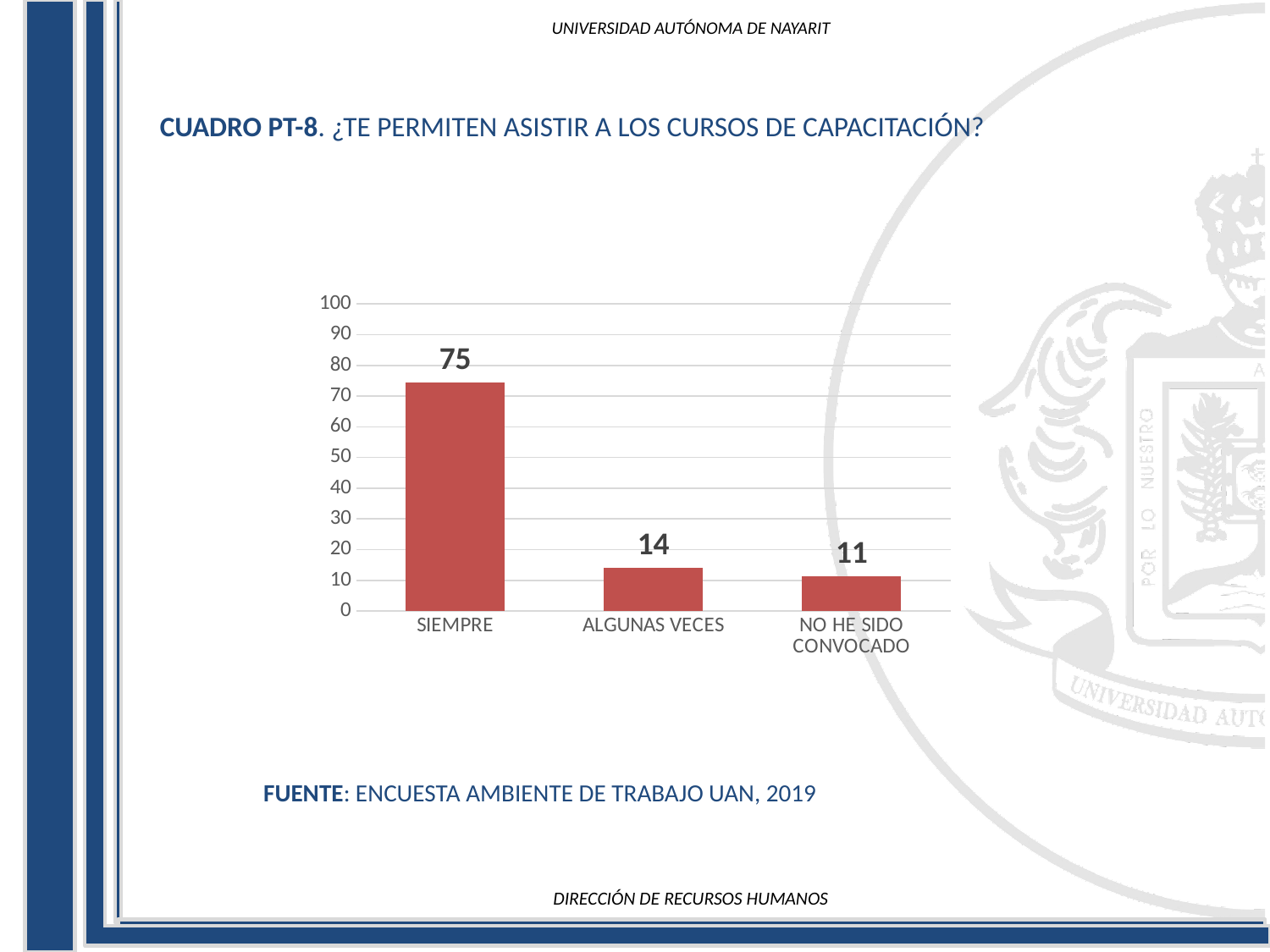
Which category has the highest value? SIEMPRE Is the value for SIEMPRE greater or less than 70? greater What is the value for NO HE SIDO CONVOCADO? 11 What kind of chart is shown on the slide? bar chart What is the value for ALGUNAS VECES? 14 Which is larger, the value for ALGUNAS VECES or the value for NO HE SIDO CONVOCADO? ALGUNAS VECES Do the values rise or fall from left to right along the x axis? fall What is the value for SIEMPRE? 75 What is the difference between the values for SIEMPRE and ALGUNAS VECES? 61 Which category has the lowest value? NO HE SIDO CONVOCADO What is the difference between the values for ALGUNAS VECES and NO HE SIDO CONVOCADO? 3 How many categories are shown on the x axis? 3